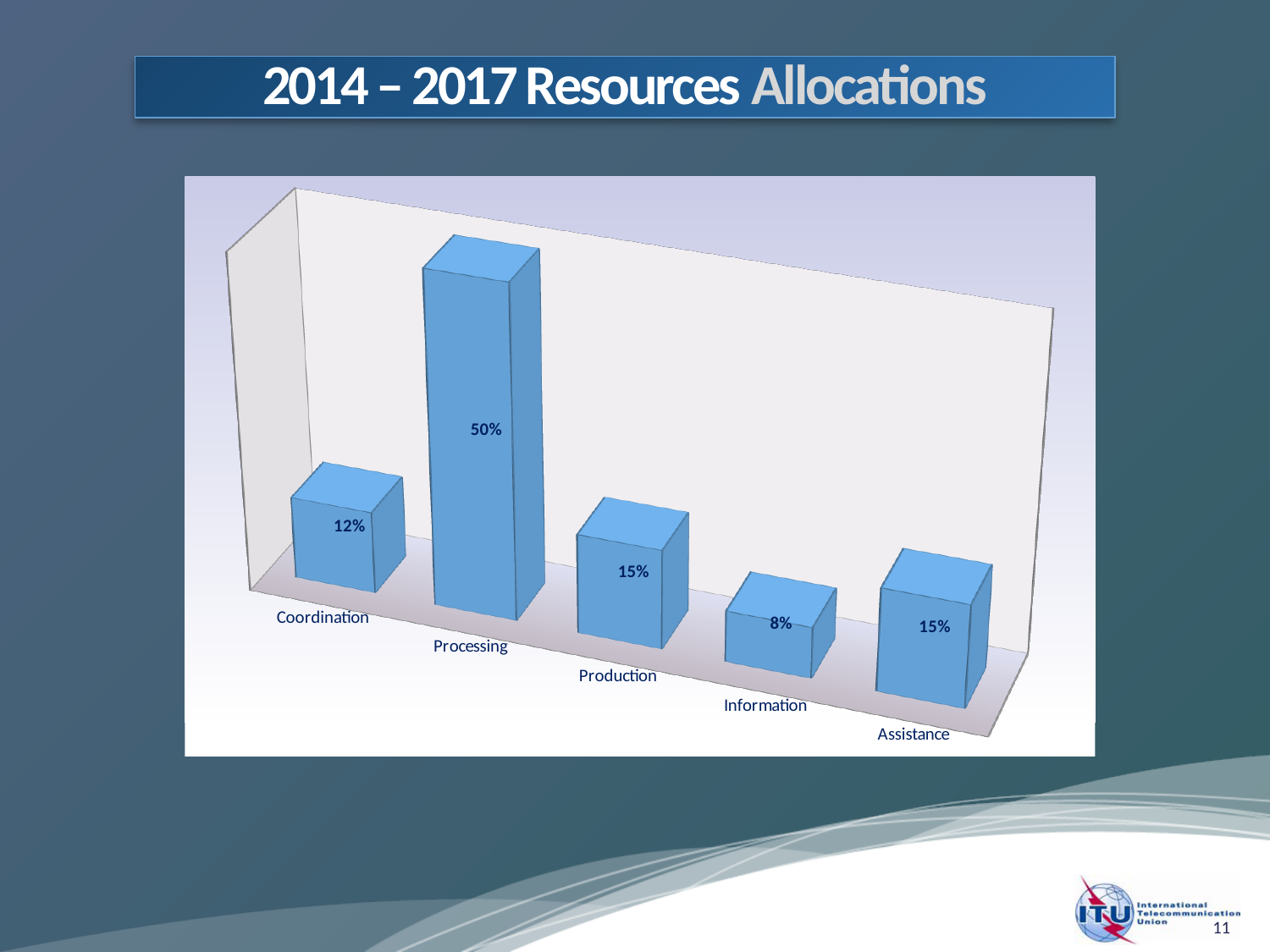
What percentage of resources is allocated to Coordination? 12% What is the title of the slide? 2014 – 2017 Resources Allocations Which category receives the smallest share of resources? Information What type of chart is shown on the slide? Bar chart What is the difference between the Processing and Production allocations? 35% Which category receives the largest share of resources? Processing What percentage of resources is allocated to Assistance? 15% Which has a larger allocation, Coordination or Production? Production What is the difference between the Coordination and Information allocations? 4% What percentage of resources is allocated to Information? 8% How many categories are shown in the chart? 5 What percentage of resources is allocated to Processing? 50%